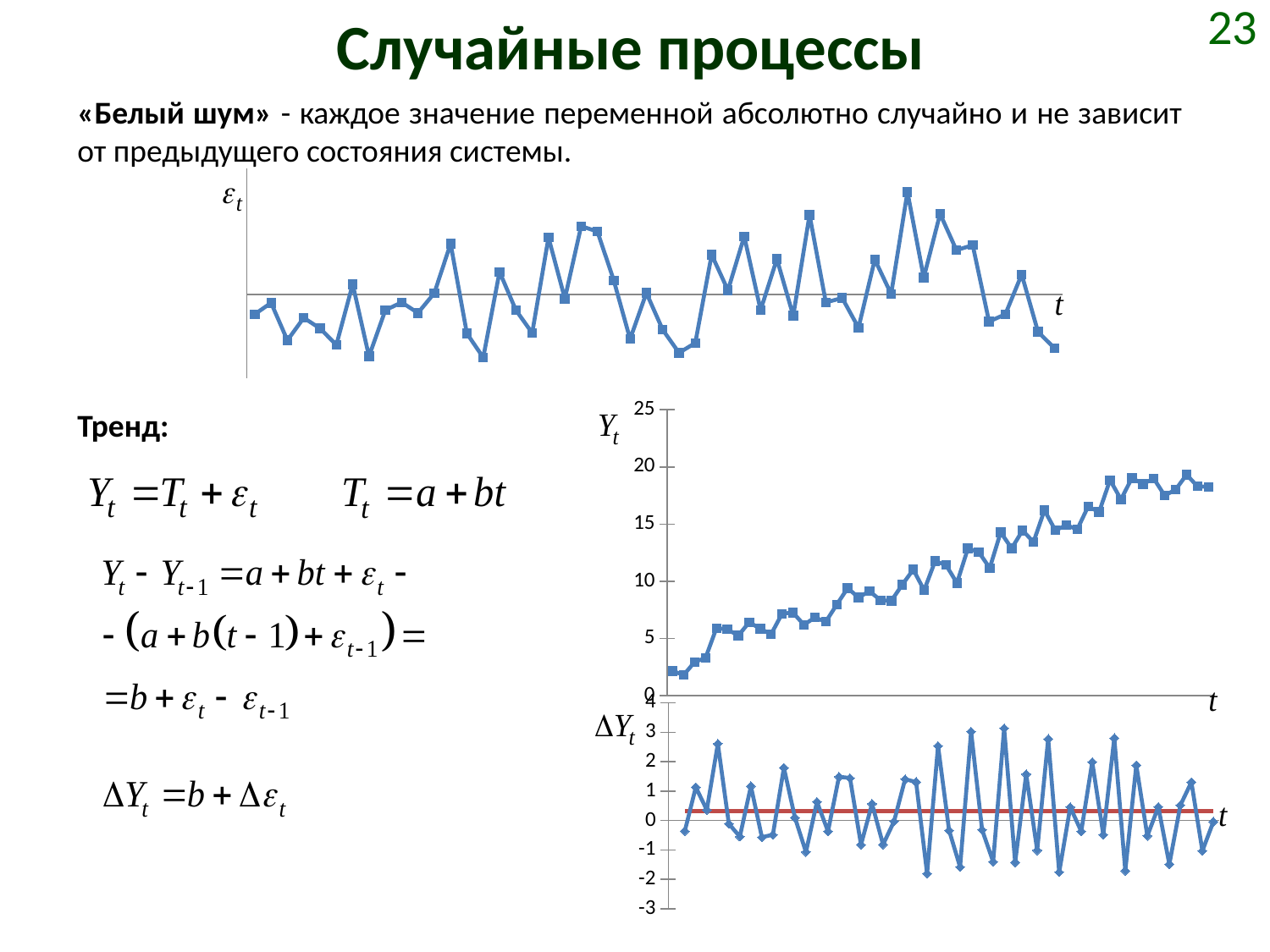
In the Y_t chart, what is the highest tick value shown on the vertical axis? 25 In the ΔY_t chart, what is the lowest tick value shown on the vertical axis? -3 In the Y_t chart, do the values generally rise or fall along the t axis? rise What colour is the horizontal straight line drawn across the ΔY_t chart? red What type of chart is the top chart labelled ε_t? line chart In the ΔY_t chart, is the highest plotted value greater or less than 2? greater In the ΔY_t chart, is the lowest plotted value greater or less than -1? less In the Y_t chart, is the first plotted value greater or less than 5? less How many charts are shown on the slide? 3 In the ΔY_t chart, what is the highest tick value shown on the vertical axis? 4 Does the ΔY_t chart show a clear upward trend along the t axis? No